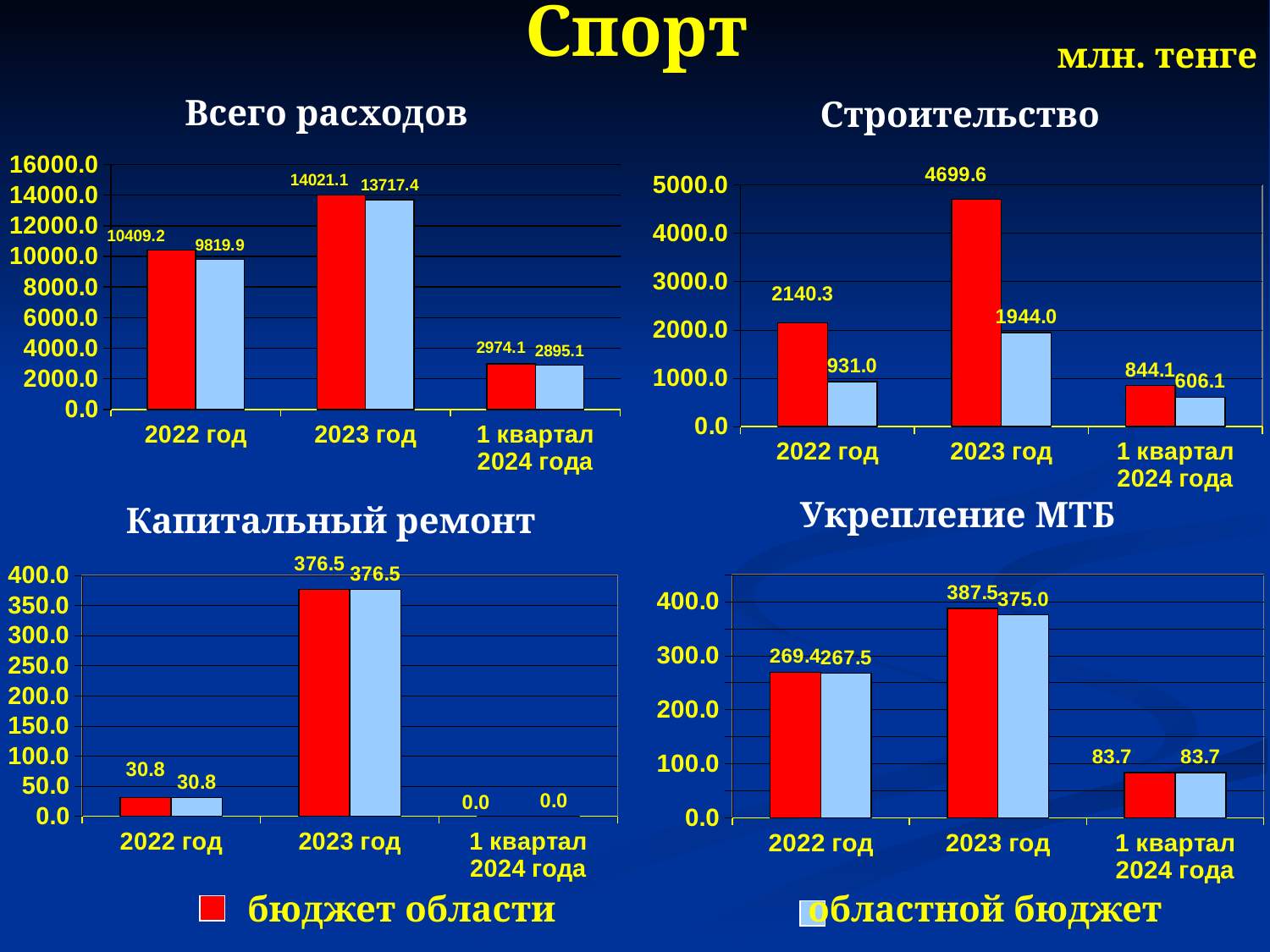
In the 'Всего расходов' chart, what is the value of the light blue 'областной бюджет' bar for 2022 год? 9819.9 In the 'Всего расходов' chart, what is the value of the red 'бюджет области' bar for 2023 год? 14021.1 In the 'Строительство' chart, which category has the highest red bar? 2023 год How many categories are shown on the x axis of the 'Строительство' chart? 3 In the 'Строительство' chart, what is the value of the red bar for 2023 год? 4699.6 In the 'Всего расходов' chart, which is larger: the red bar for 2022 год or the red bar for 1 квартал 2024 года? 2022 год In the 'Укрепление МТБ' chart, what is the difference between the red and light blue bars for 2023 год? 12.5 In the 'Капитальный ремонт' chart, which category has the lowest values? 1 квартал 2024 года What type of chart is the 'Укрепление МТБ' chart? Bar chart In the 'Капитальный ремонт' chart, what is the value of the light blue bar for 1 квартал 2024 года? 0.0 In the 'Строительство' chart, what is the difference between the red and light blue bars for 2022 год? 1209.3 In the 'Укрепление МТБ' chart, what is the value of the light blue bar for 2023 год? 375.0